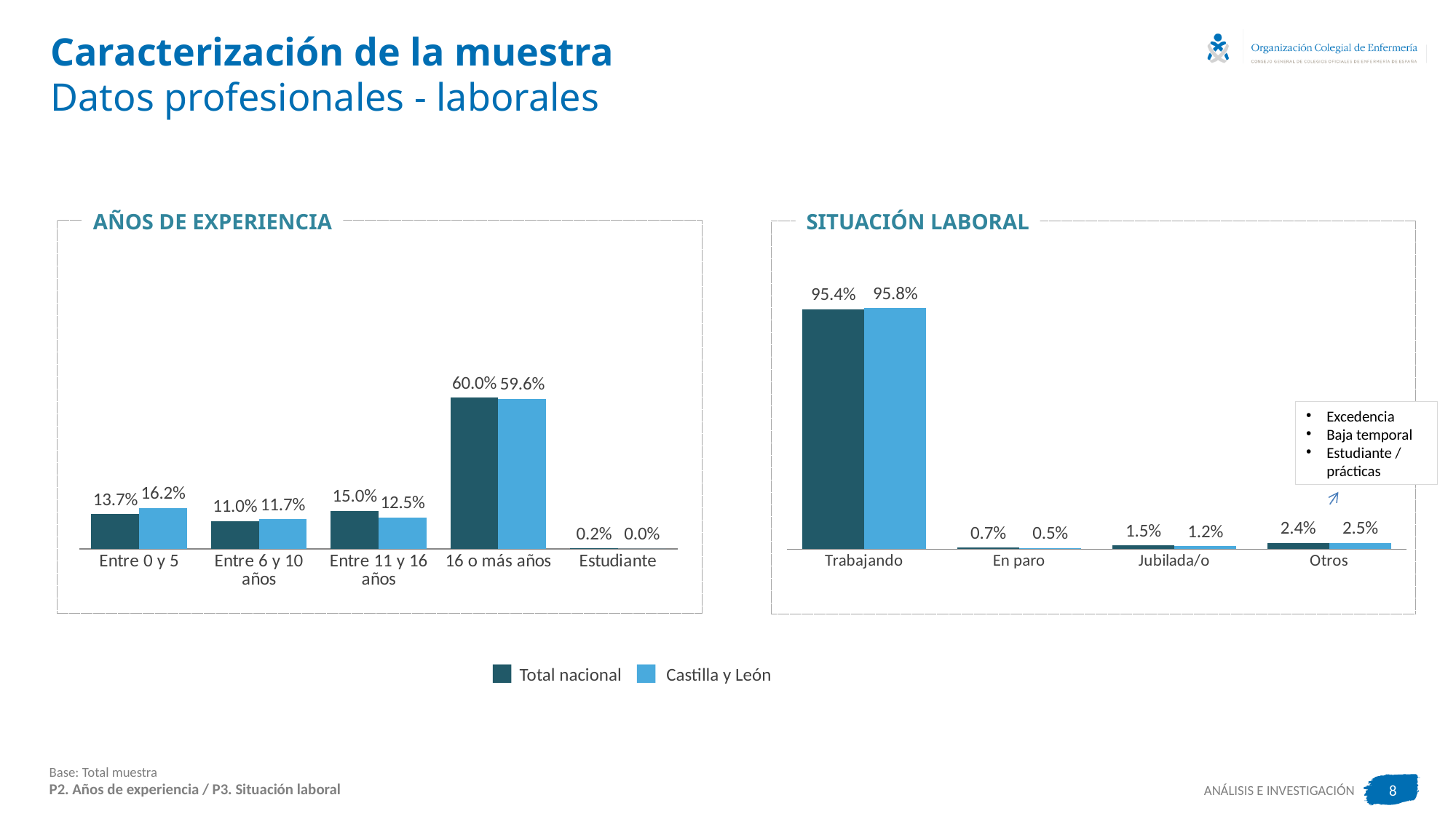
In the AÑOS DE EXPERIENCIA chart, what is the Castilla y León value for 'Entre 0 y 5'? 16.2% In the AÑOS DE EXPERIENCIA chart, which category has the highest Total nacional value? 16 o más años In the SITUACIÓN LABORAL chart, what is the Castilla y León value for 'Trabajando'? 95.8% In the AÑOS DE EXPERIENCIA chart, which category has the lowest Castilla y León value? Estudiante In the SITUACIÓN LABORAL chart, what is the Total nacional value for 'Jubilada/o'? 1.5% In the AÑOS DE EXPERIENCIA chart, what is the Total nacional value for '16 o más años'? 60.0% In the AÑOS DE EXPERIENCIA chart, what is the difference between the Total nacional and Castilla y León values for 'Entre 11 y 16 años'? 2.5% What type of chart is the SITUACIÓN LABORAL chart? Bar chart In the SITUACIÓN LABORAL chart, what is the difference between the Castilla y León and Total nacional values for 'Trabajando'? 0.4% How many series does the legend list? 2 In the SITUACIÓN LABORAL chart, which is larger for 'En paro': Total nacional or Castilla y León? Total nacional In the AÑOS DE EXPERIENCIA chart, how many categories are shown on the x axis? 5